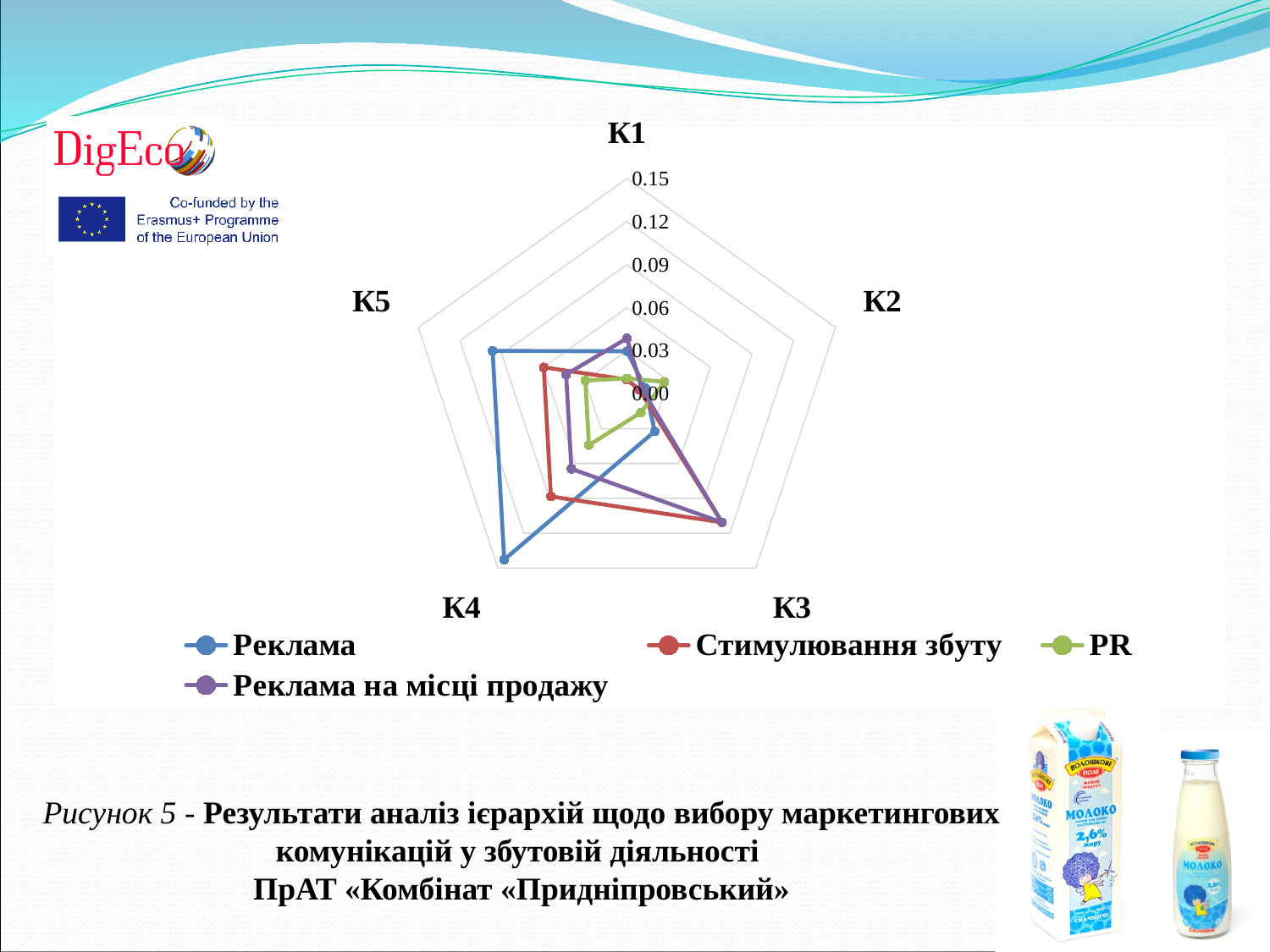
What is the highest value shown on the chart's axis scale? 0.15 Which series has the lowest value at K4? PR Is the value for Реклама at K4 greater or less than 0.12? greater Is the value for PR at K4 greater or less than 0.09? less How many series does the legend list? 4 Is the value for Реклама at K5 greater or less than 0.06? greater Which series has the highest value at K4? Реклама Which series is drawn in blue? Реклама What kind of chart is shown on the slide? radar chart How many categories (axes) does the radar chart have? 5 At K3, which is larger: the value for Реклама or the value for Стимулювання збуту? Стимулювання збуту